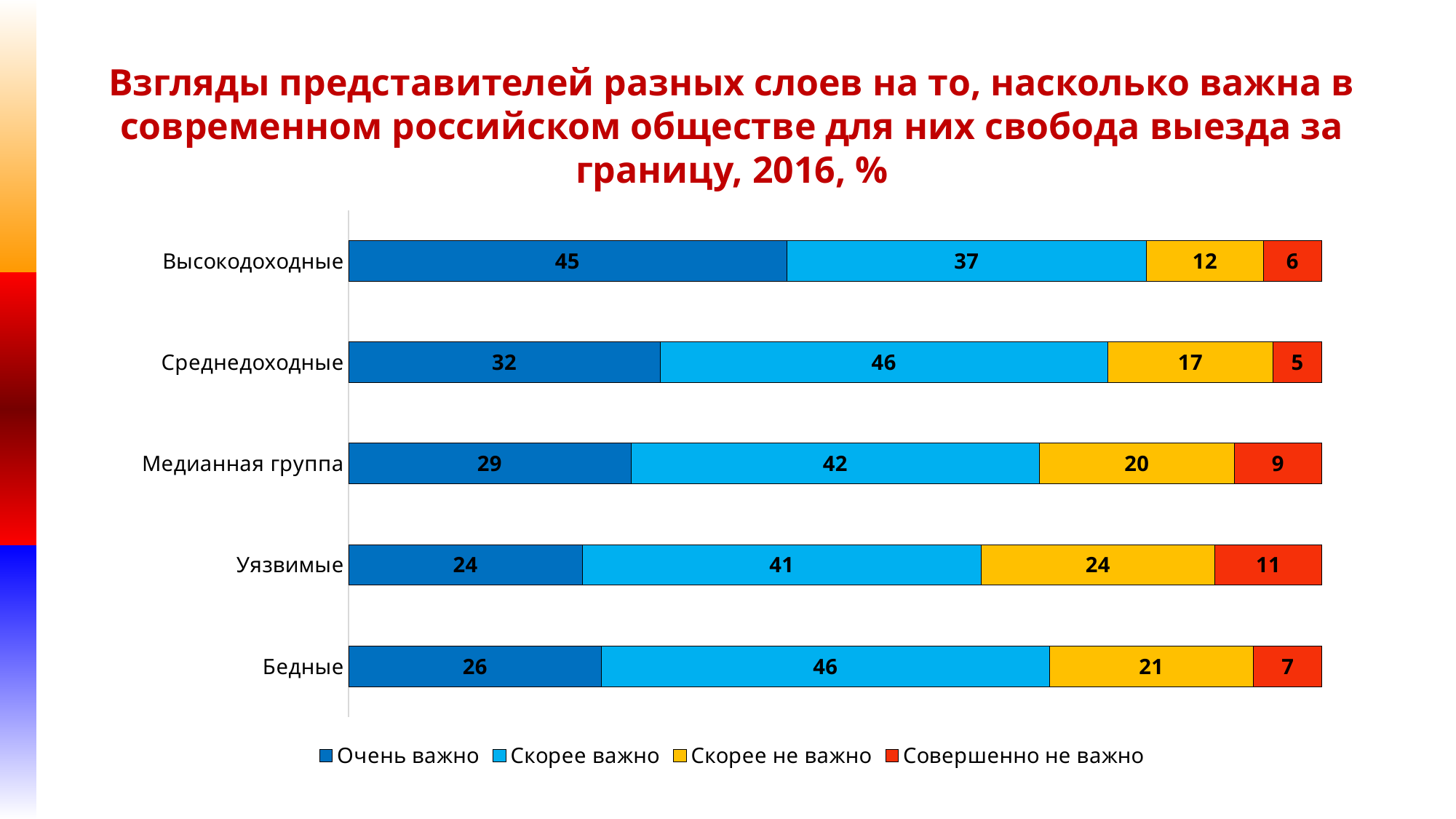
Which is larger: the "Очень важно" value for Бедные or for Уязвимые? Бедные How many categories are shown on the chart? 5 What kind of chart is shown on the slide? Stacked bar chart What is the value of "Совершенно не важно" for Среднедоходные? 5 What is the value of "Скорее не важно" for Уязвимые? 24 Which category has the lowest value for "Совершенно не важно"? Среднедоходные Which category has the highest value for "Очень важно"? Высокодоходные What is the value of "Очень важно" for Высокодоходные? 45 What is the difference between the "Скорее важно" values for Среднедоходные and Высокодоходные? 9 How many series does the legend list? 4 Which colour represents "Скорее не важно" in the legend? Yellow What is the total of the stacked bar for Медианная группа? 100